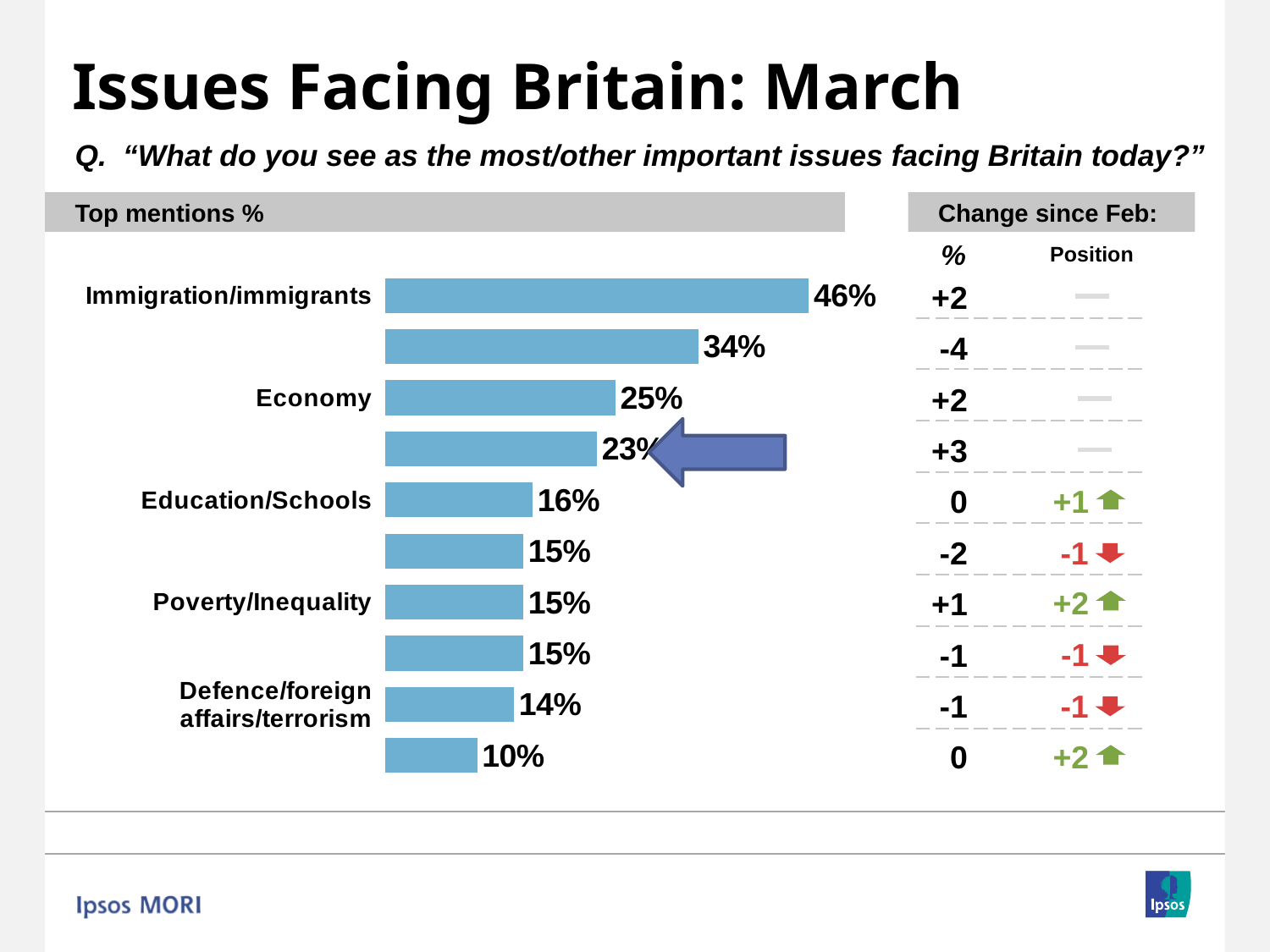
What percentage is shown for Economy? 25% What percentage is shown for Education/Schools? 16% Which has a higher percentage, Economy or Education/Schools? Economy What is the lowest percentage value shown on the chart? 10% What percentage is shown for Defence/foreign affairs/terrorism? 14% What is the change since Feb in % for Immigration/immigrants? +2 What percentage is shown for Immigration/immigrants? 46% Which issue has the highest percentage of mentions? Immigration/immigrants How many bars are shown on the chart? 10 What kind of chart is shown on the slide? Bar chart What percentage is shown for Poverty/Inequality? 15% What is the difference in percentage points between Immigration/immigrants and Economy? 21